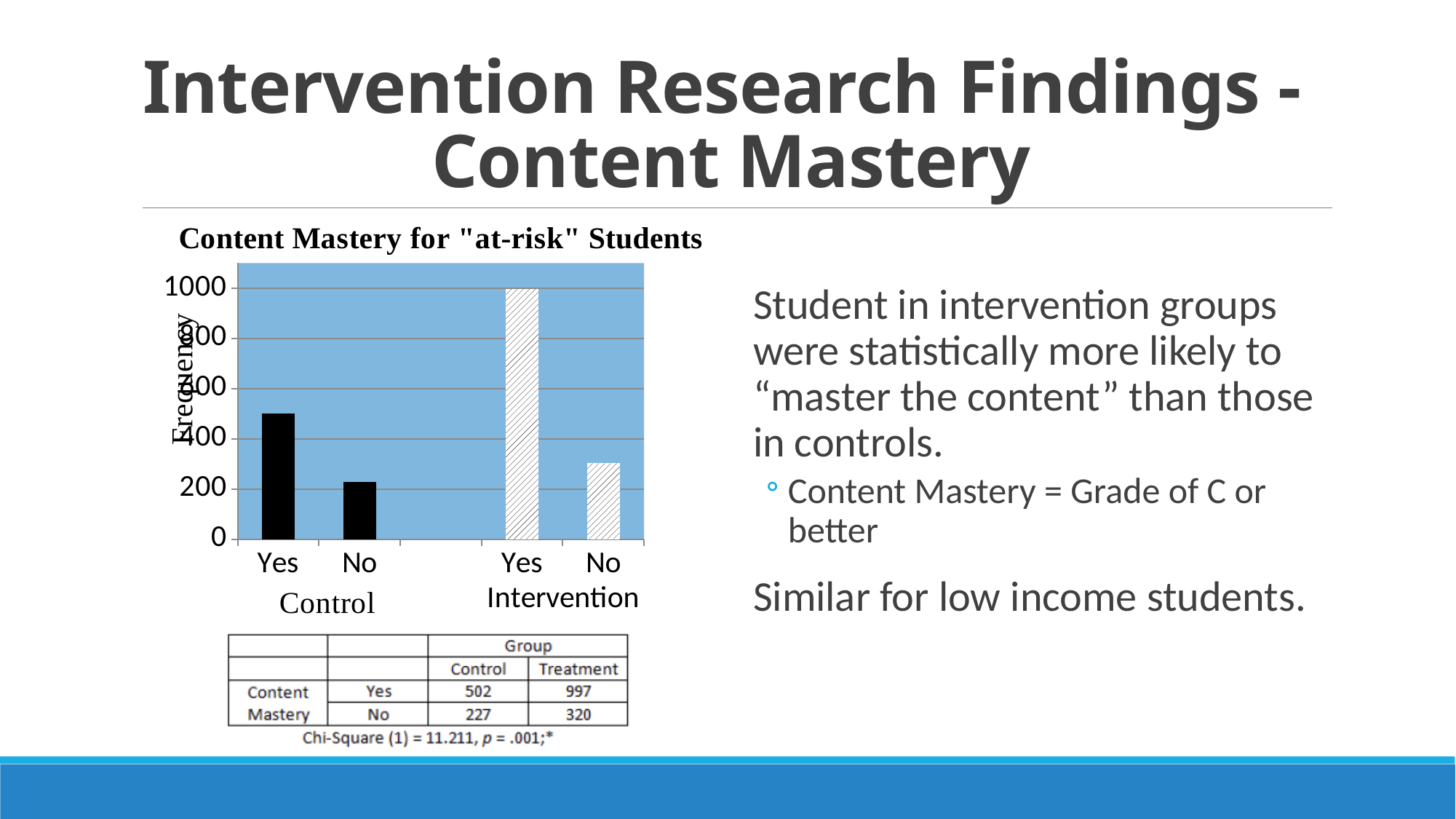
What is the label on the vertical axis of the chart? Frequency What is the title of the chart? Content Mastery for "at-risk" Students Is the value for Intervention No greater or less than 400? less Which bar is the lowest in the chart? Control No Is the value for Control No greater or less than 200? greater According to the table below the chart, what is the Control group's Content Mastery 'Yes' count? 502 How many bars are plotted in the chart? 4 Which bar is the highest in the chart? Intervention Yes Is the value for Control Yes greater or less than 400? greater Which is larger, the Control Yes bar or the Intervention No bar? Control Yes What kind of chart is shown on the slide? bar chart